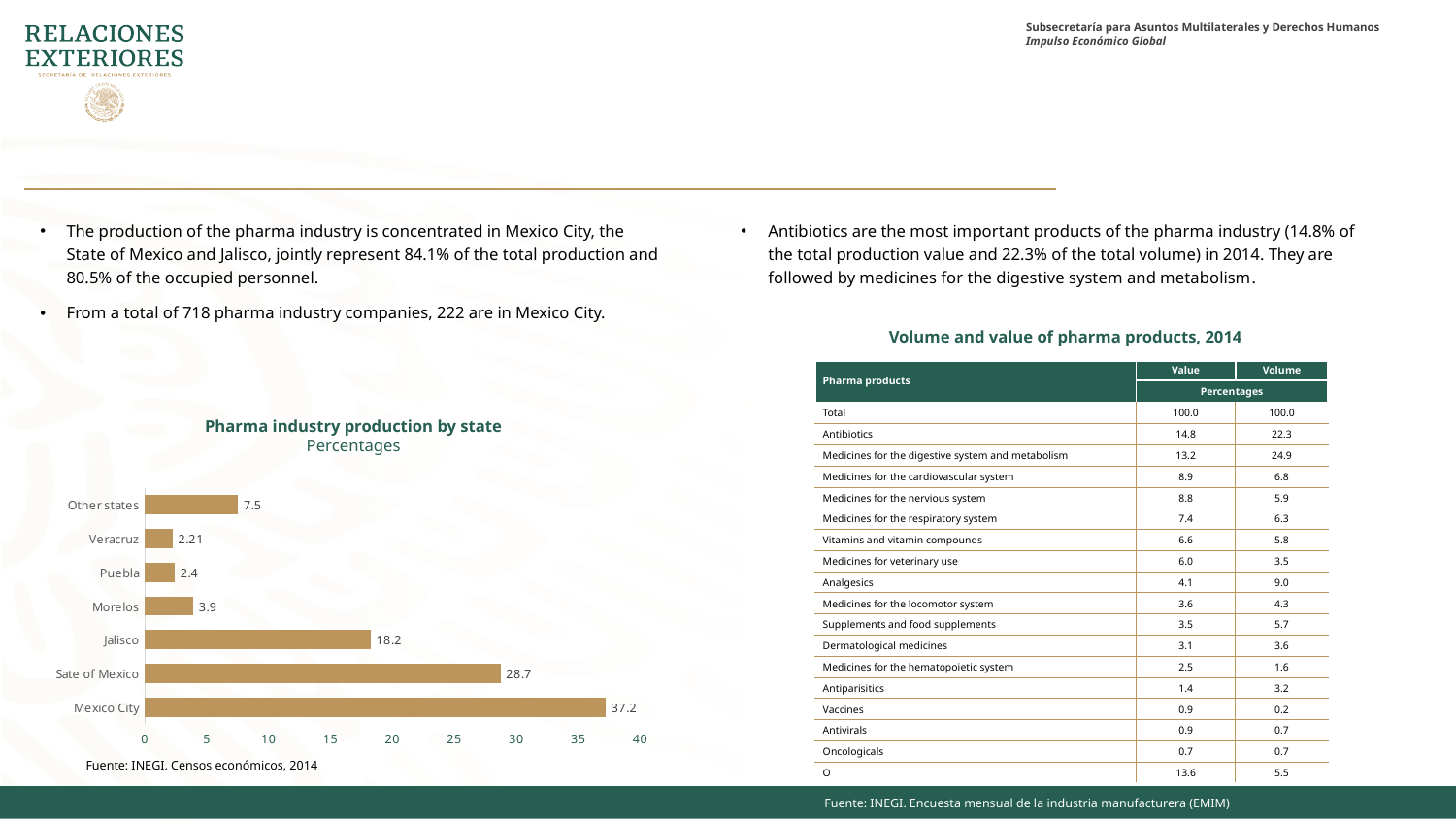
Is the value for Jalisco in the Pharma industry production by state chart greater or less than 15? greater What unit is indicated in the subtitle of the Pharma industry production by state chart? Percentages What is the value for Jalisco in the Pharma industry production by state chart? 18.2 What is the value for Veracruz in the Pharma industry production by state chart? 2.21 What is the difference between the values for Mexico City and State of Mexico in the Pharma industry production by state chart? 8.5 Which state has the highest value in the Pharma industry production by state chart? Mexico City Which category has the lowest value in the Pharma industry production by state chart? Veracruz How many categories are shown in the Pharma industry production by state chart? 7 What is the value for Mexico City in the Pharma industry production by state chart? 37.2 What is the difference between the values for Jalisco and Other states in the Pharma industry production by state chart? 10.7 What kind of chart is the Pharma industry production by state chart? Bar chart Which is larger in the Pharma industry production by state chart, the value for Morelos or the value for Puebla? Morelos